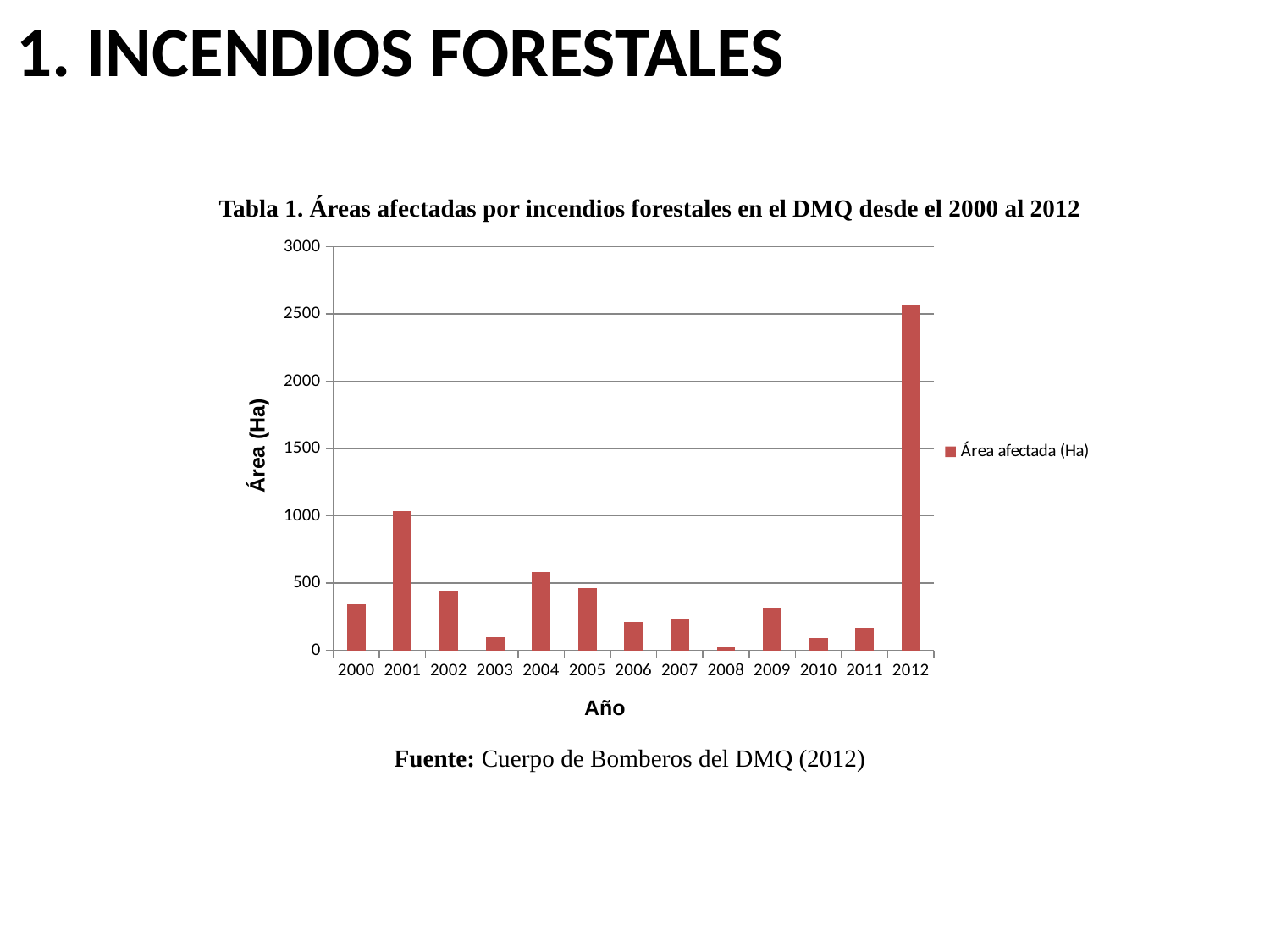
Is the value for 2012 greater or less than 2500? greater Which year has the larger value, 2001 or 2004? 2001 Which year has the lowest value for Área afectada (Ha)? 2008 Which year has the larger value, 2000 or 2003? 2000 How many years are shown on the x axis of the chart? 13 Is the value for 2003 greater or less than 500? less How many series does the legend list? 1 Which year has the highest value for Área afectada (Ha)? 2012 Is the value for 2004 greater or less than 500? greater What kind of chart is shown on the slide? bar chart What is the title of the y axis of the chart? Área (Ha)